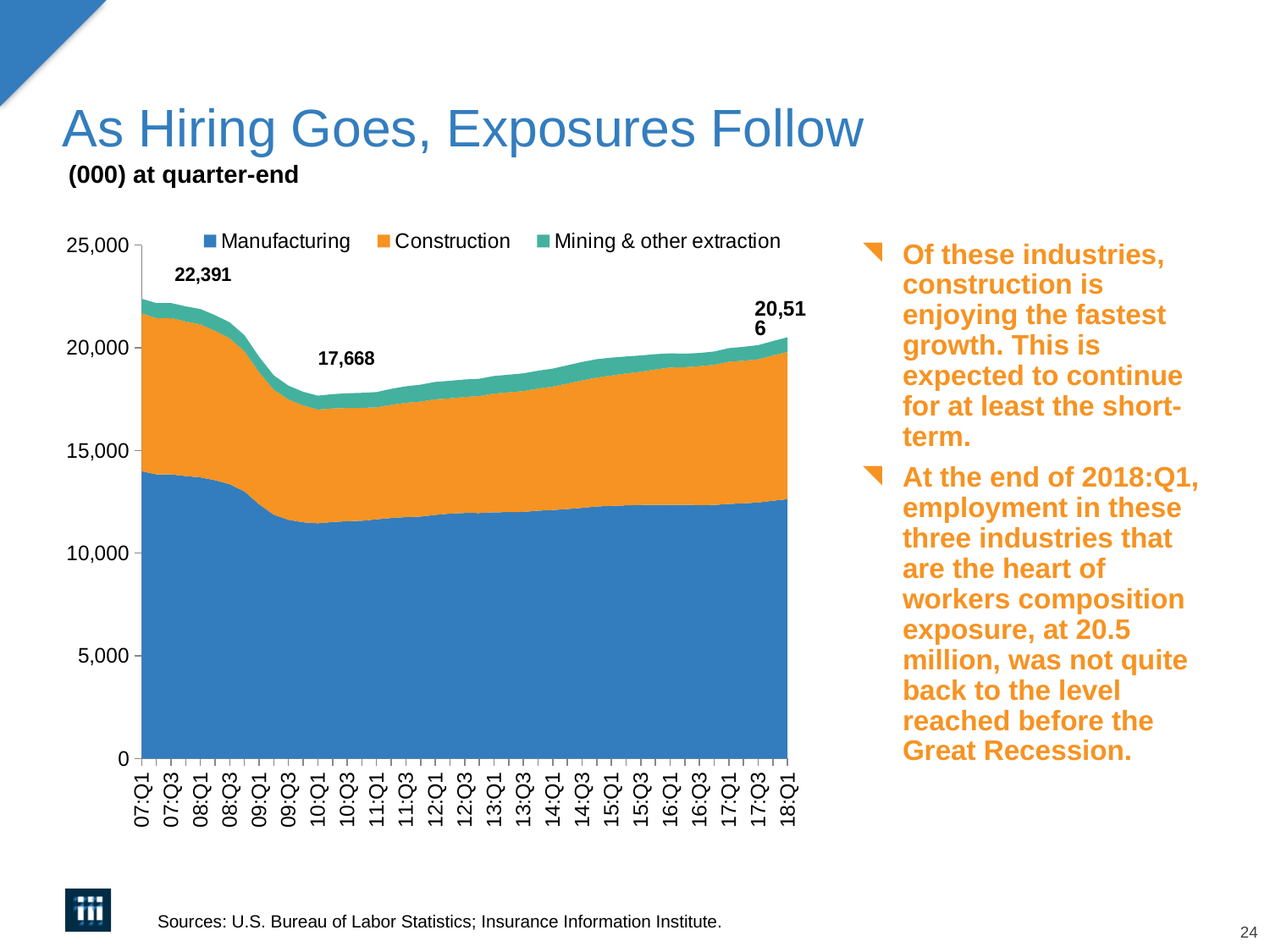
What kind of chart is shown on the slide? Stacked area chart Which series contributes the smallest share of the stacked total throughout the chart? Mining & other extraction At 18:Q1, which is larger, the Manufacturing series or the Construction series? Manufacturing Which three series are listed in the chart's legend? Manufacturing, Construction, Mining & other extraction What is the labeled total employment value at 18:Q1? 20,516 What is the lowest total value labeled on the chart? 17,668 What is the highest total value labeled on the chart? 22,391 What is the difference between the labeled peak total of 22,391 and the labeled 18:Q1 total of 20,516? 1,875 How many series does the chart's legend list? 3 Is the Manufacturing value at 07:Q1 greater or less than 15,000? less Does the total employment rise or fall from 10:Q1 to 18:Q1? Rise What is the difference between the labeled peak total of 22,391 and the labeled trough total of 17,668? 4,723